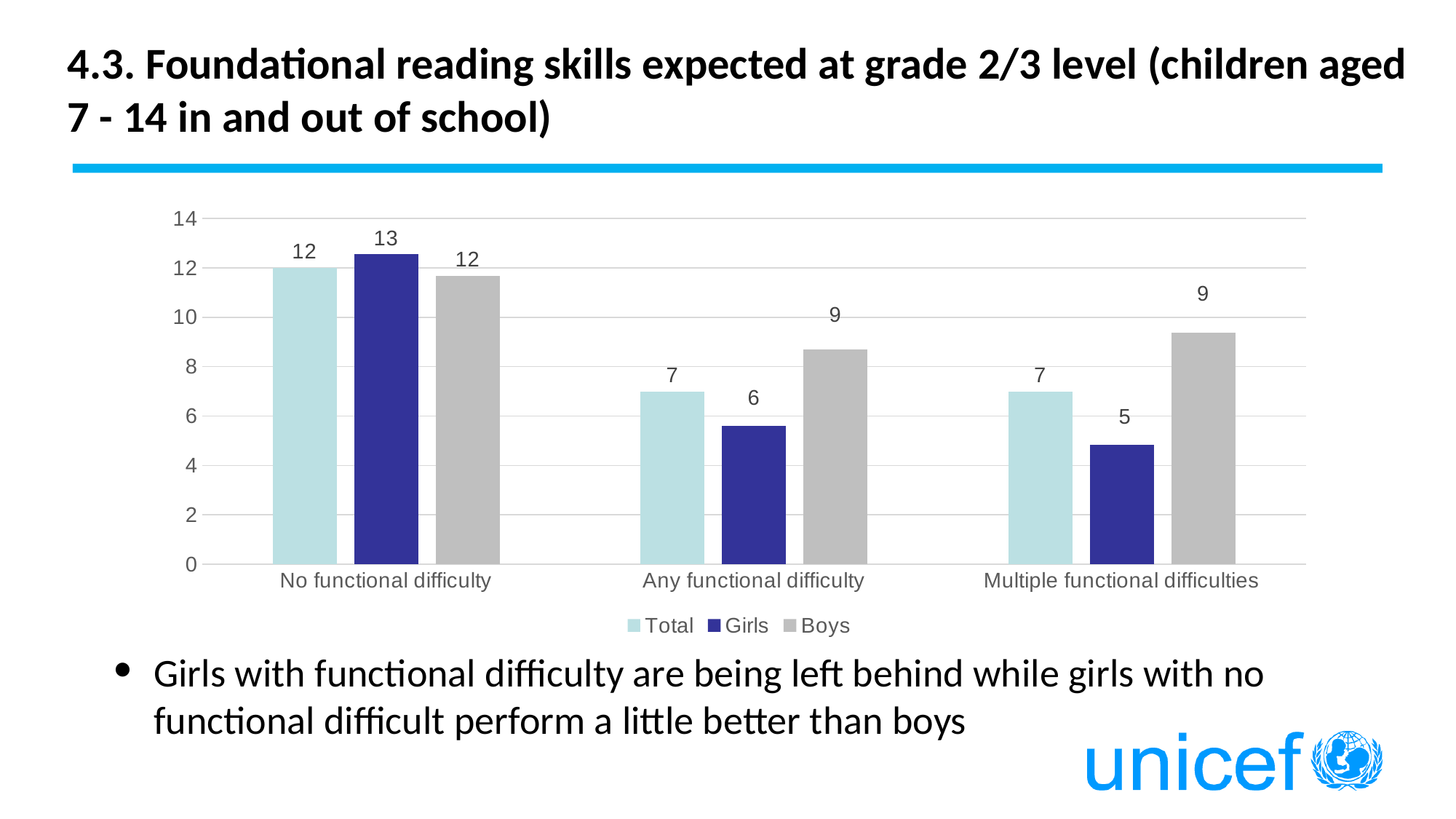
How many categories are shown on the x axis? 3 What is the value for Boys in the Any functional difficulty category? 9 What is the value for Girls in the Multiple functional difficulties category? 5 Is the value for Boys in the Multiple functional difficulties category greater or less than 8? greater What kind of chart is shown on the slide? bar chart What is the difference between the Boys and Girls values in the Any functional difficulty category? 3 Which series has the highest value in the No functional difficulty category? Girls Which series has the lowest value in the Multiple functional difficulties category? Girls In the Multiple functional difficulties category, which is larger, the value for Boys or the value for Girls? Boys What is the value for Girls in the No functional difficulty category? 13 How many series does the legend list? 3 What is the value for Total in the Multiple functional difficulties category? 7